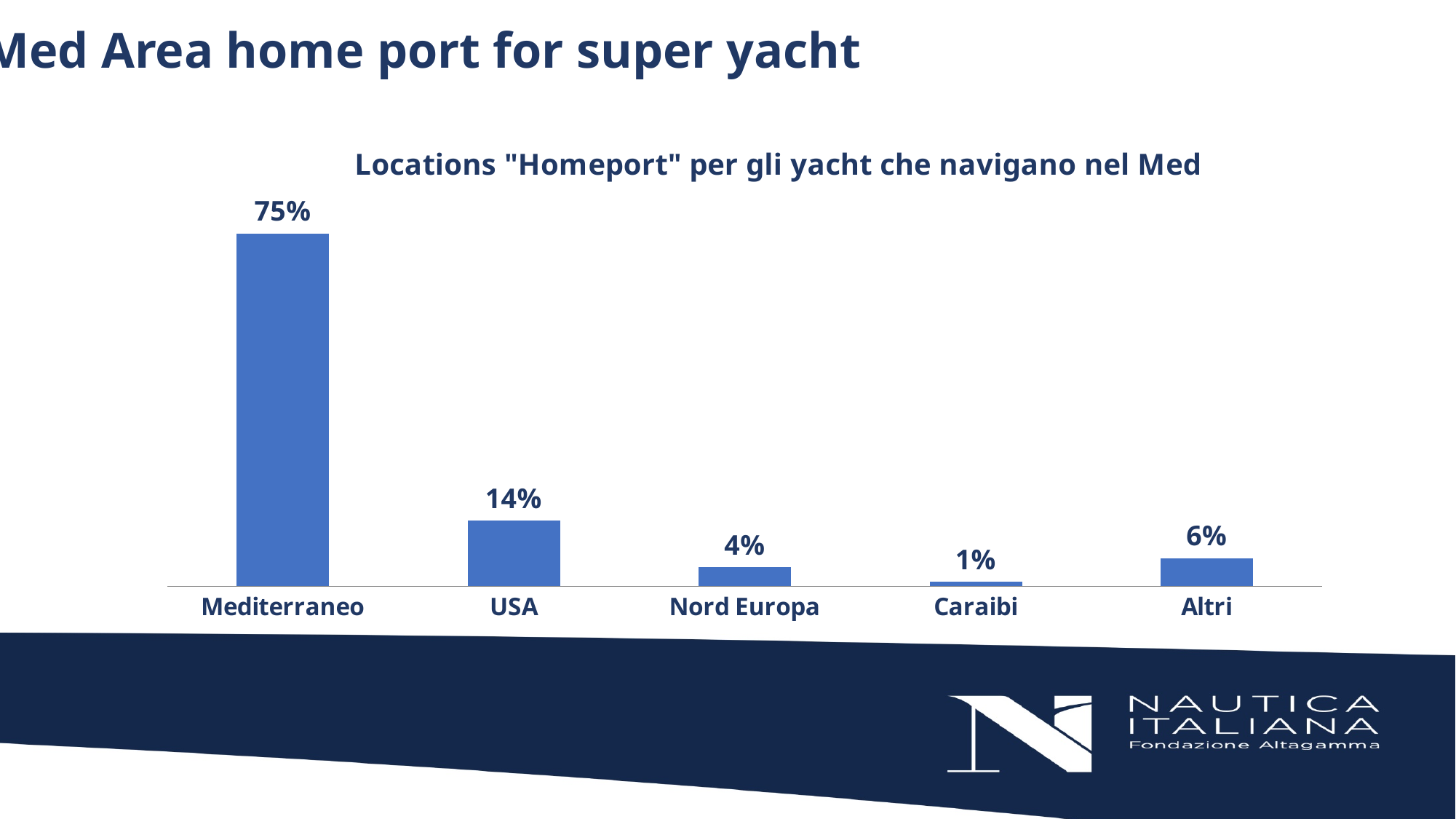
What is the value for USA? 14% What is the title of the chart? Locations "Homeport" per gli yacht che navigano nel Med What is the difference between the values for Mediterraneo and USA? 61% Which category has the highest value? Mediterraneo Which is larger, the value for Altri or the value for Nord Europa? Altri Which category has the lowest value? Caraibi What is the value for Mediterraneo? 75% What is the value for Nord Europa? 4% How many categories are shown in the chart? 5 What kind of chart is shown on the slide? Bar chart What is the value for Caraibi? 1% What is the value for Altri? 6%